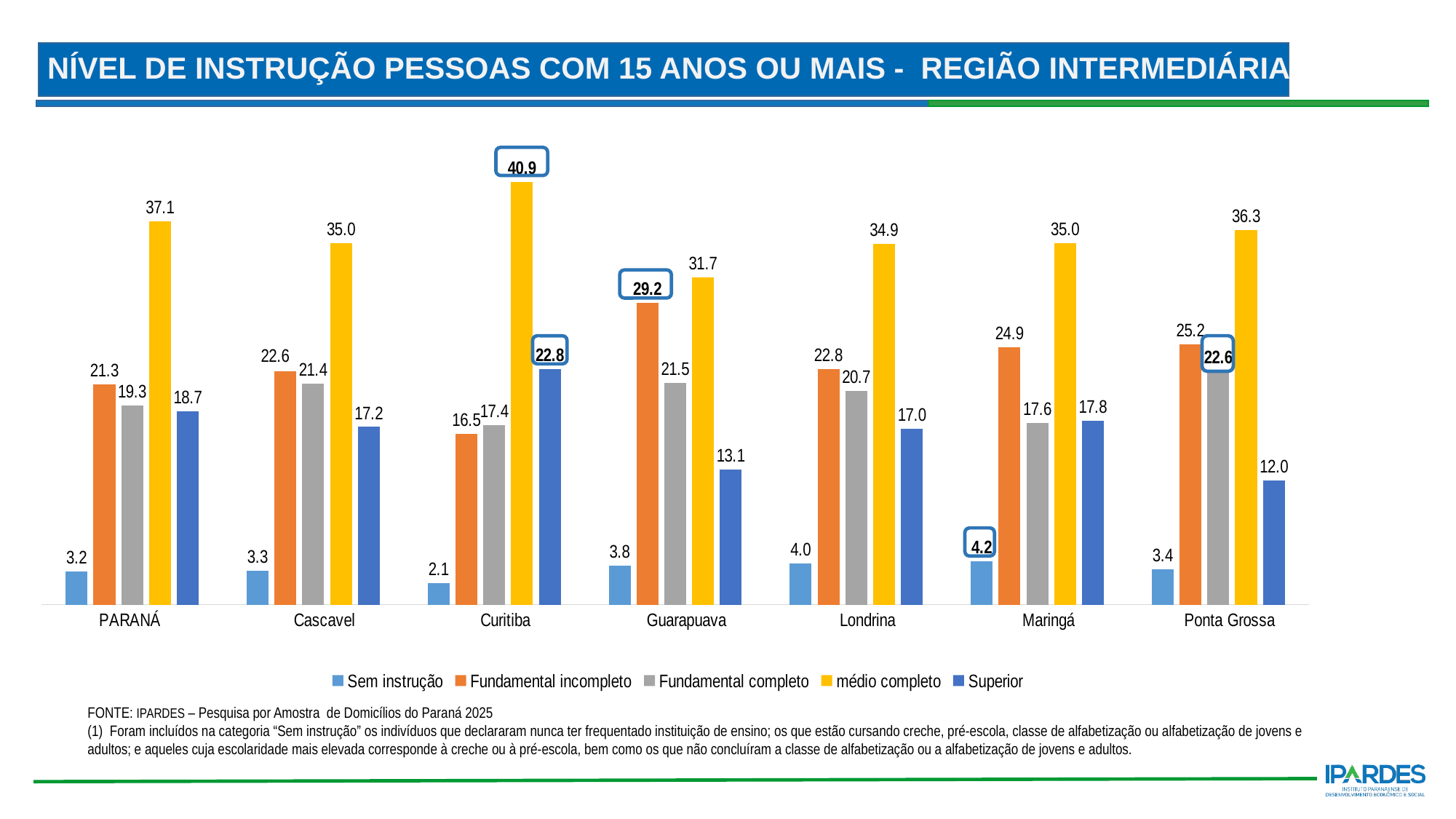
What kind of chart is shown on the slide? Bar chart Which region has the lowest value for "Superior"? Ponta Grossa How many regions (categories) are shown on the x axis? 7 What is the value for "Fundamental incompleto" in Guarapuava? 29.2 Which region has the highest value for "Sem instrução"? Maringá What is the difference between the "médio completo" values for Curitiba and Guarapuava? 9.2 What is the difference between the "Superior" values for Curitiba and PARANÁ? 4.1 What is the value for "Superior" in Ponta Grossa? 12.0 What is the value for "médio completo" in Curitiba? 40.9 Which series is shown in yellow? médio completo Which is larger: the "Fundamental completo" value for Ponta Grossa or for Londrina? Ponta Grossa How many series does the legend list? 5